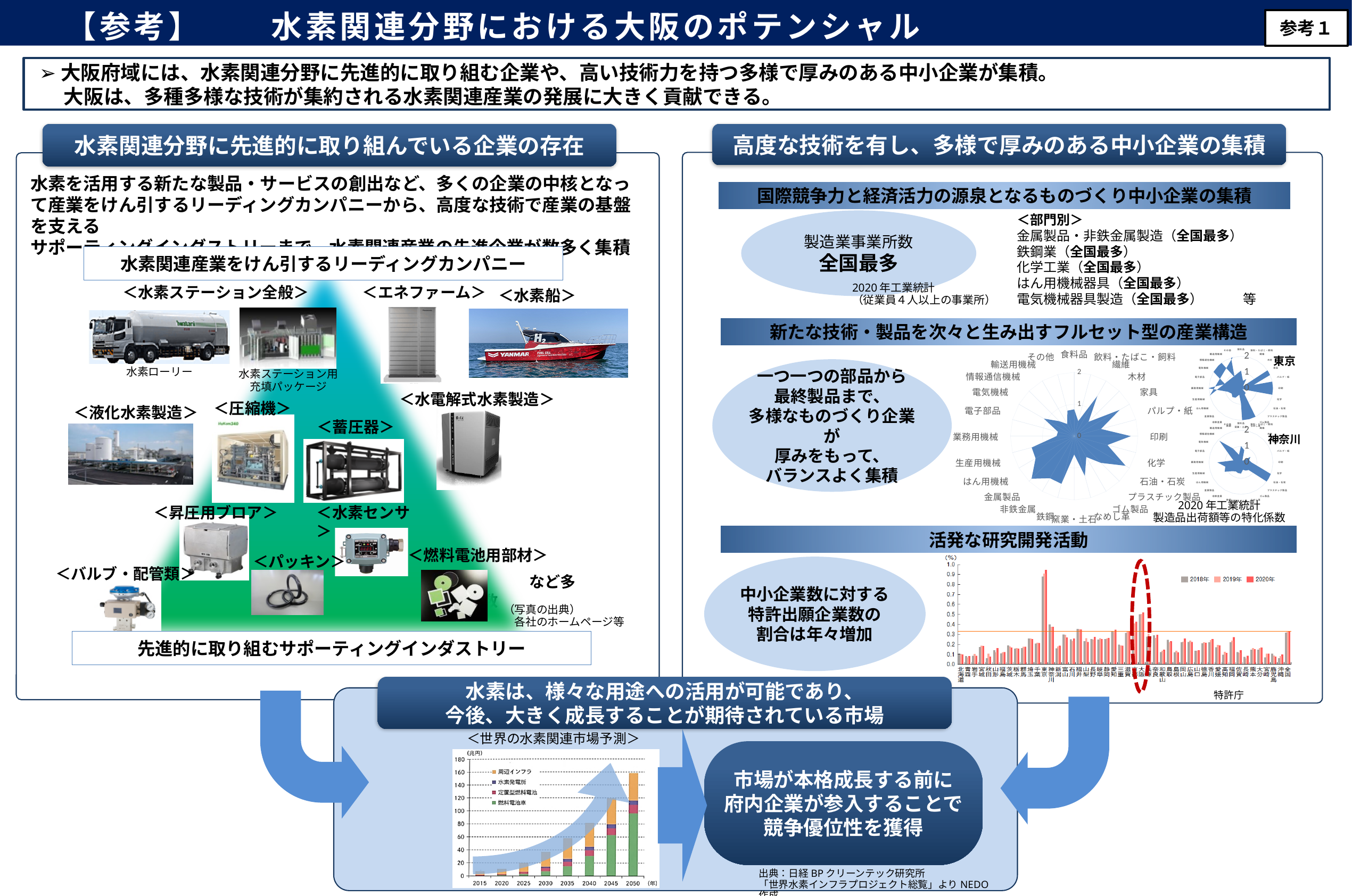
How many series does the legend of the patent application ratio bar chart (活発な研究開発活動 section) list? 3 What kind of chart is shown under 新たな技術・製品を次々と生み出すフルセット型の産業構造? radar chart How many series does the legend of the ＜世界の水素関連市場予測＞ chart list? 4 In the ＜世界の水素関連市場予測＞ chart, which is larger, the stacked total for 2045 or for 2035? 2045 In the ＜世界の水素関連市場予測＞ chart, which year has the highest stacked total? 2050 What unit is shown on the y axis of the ＜世界の水素関連市場予測＞ chart? 兆円 In the ＜世界の水素関連市場予測＞ chart, do the stacked totals rise or fall from 2015 to 2050? rise How many years are shown on the x axis of the ＜世界の水素関連市場予測＞ chart? 8 What kind of chart is the ＜世界の水素関連市場予測＞ chart at the bottom of the slide? stacked bar chart In the ＜世界の水素関連市場予測＞ chart, which year has the lowest stacked total? 2015 In the ＜世界の水素関連市場予測＞ chart, is the stacked total for 2050 greater or less than 140? greater In the ＜世界の水素関連市場予測＞ chart, is the stacked total for 2030 greater or less than 60? less